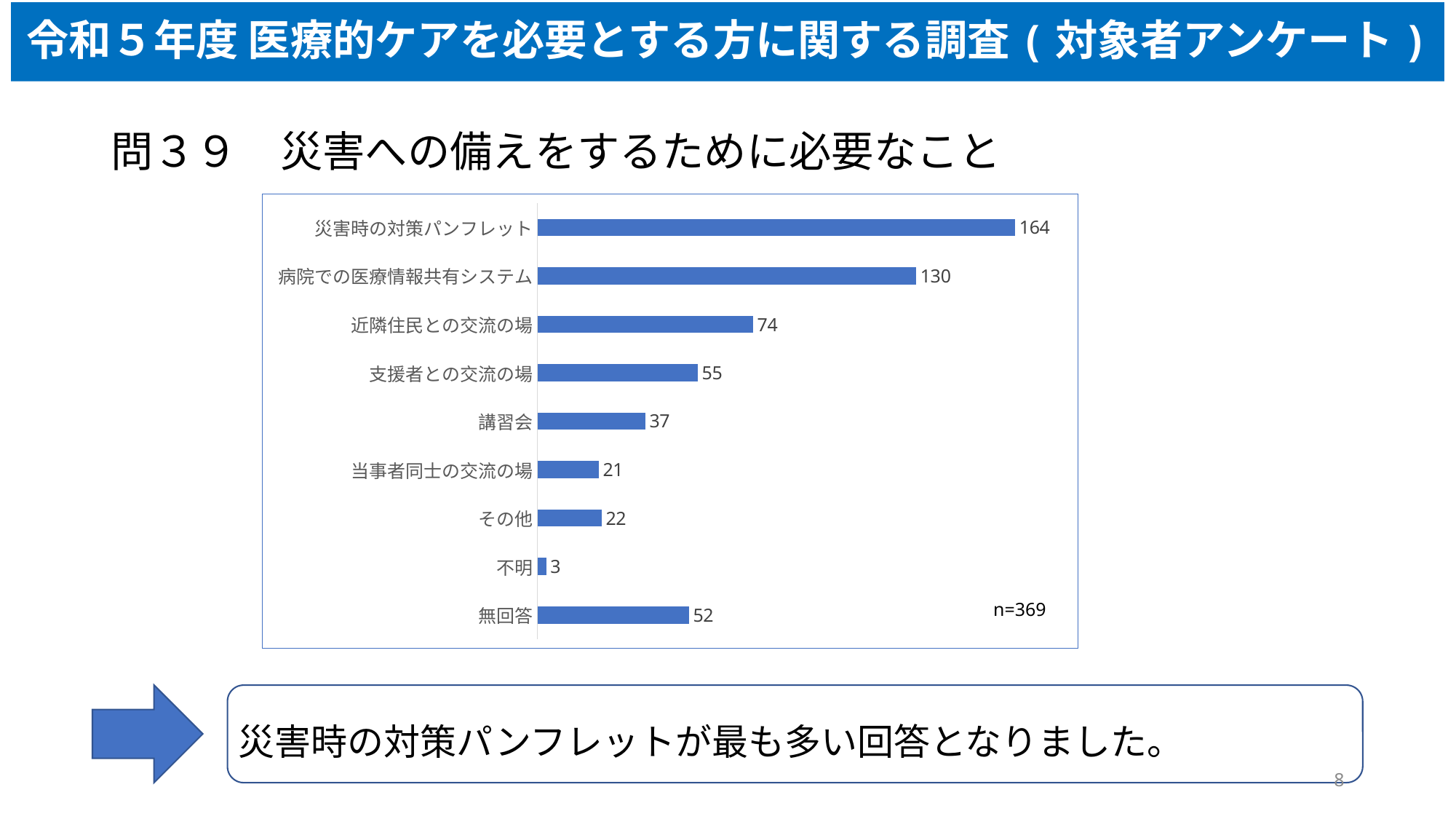
Which category has the lowest value? 不明 What is the sample size (n) shown on the chart? n=369 What is the difference between the values for 近隣住民との交流の場 and 支援者との交流の場? 19 What is the value for 講習会? 37 Which category has the highest value? 災害時の対策パンフレット How many categories are shown in the chart? 9 Which is larger, the value for 支援者との交流の場 or the value for 無回答? 支援者との交流の場 What is the difference between the values for 災害時の対策パンフレット and 病院での医療情報共有システム? 34 What is the value for 無回答? 52 What is the value for 災害時の対策パンフレット? 164 What kind of chart is shown on the slide? bar chart What is the value for 病院での医療情報共有システム? 130